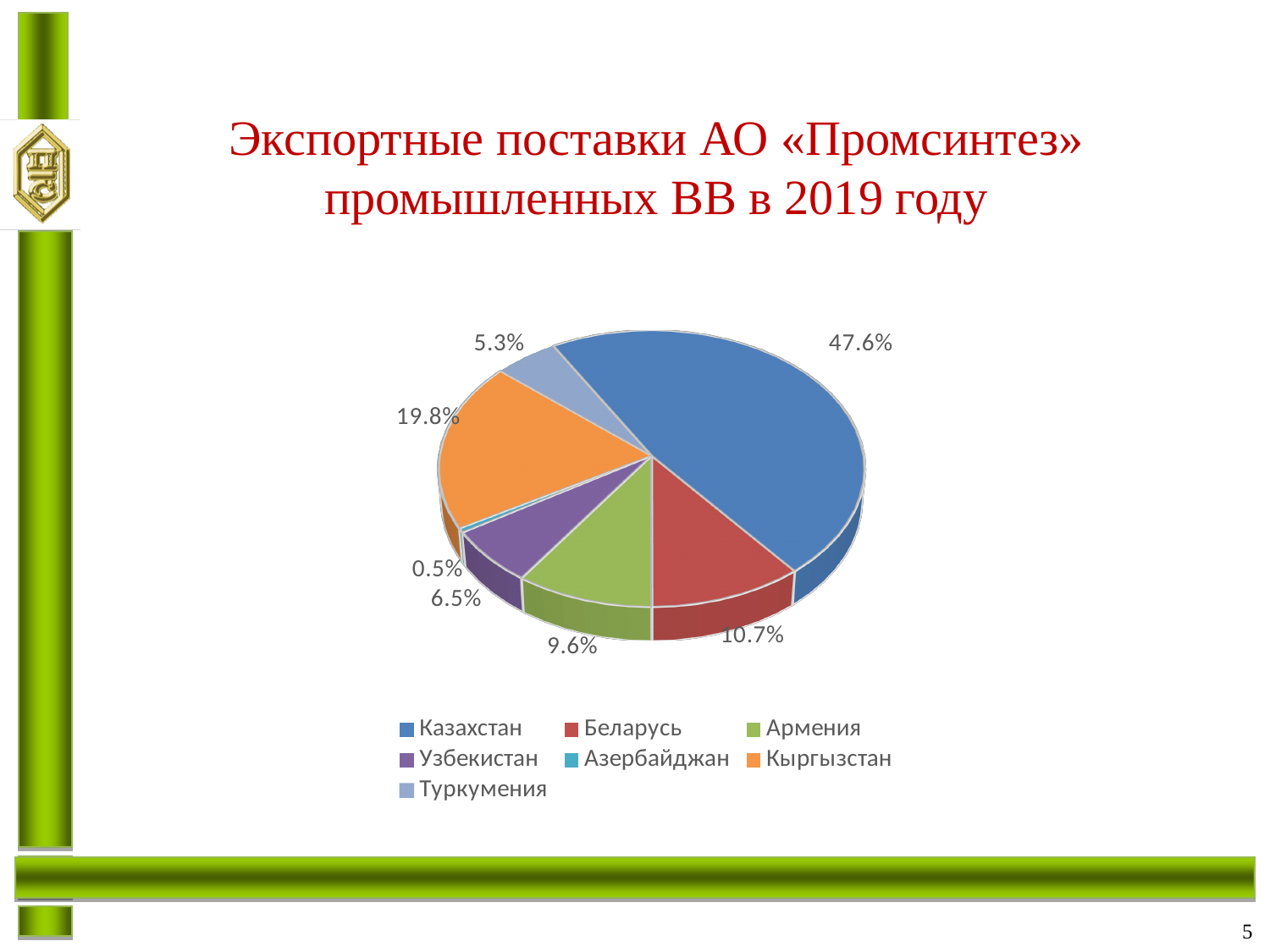
What kind of chart is shown on the slide? Pie chart Which is larger, the share of Узбекистан or the share of Туркумения? Узбекистан What is the difference between the shares of Казахстан and Кыргызстан? 27.8% What is the value shown for Кыргызстан? 19.8% What share of the pie does Казахстан hold? 47.6% Which colour represents Армения in the legend? Green Which country has the smallest slice of the pie? Азербайджан What is the value shown for Беларусь? 10.7% What is the value shown for Туркумения? 5.3% How many countries are shown in the pie chart? 7 What is the difference between the shares of Беларусь and Армения? 1.1% Which country has the largest slice of the pie? Казахстан